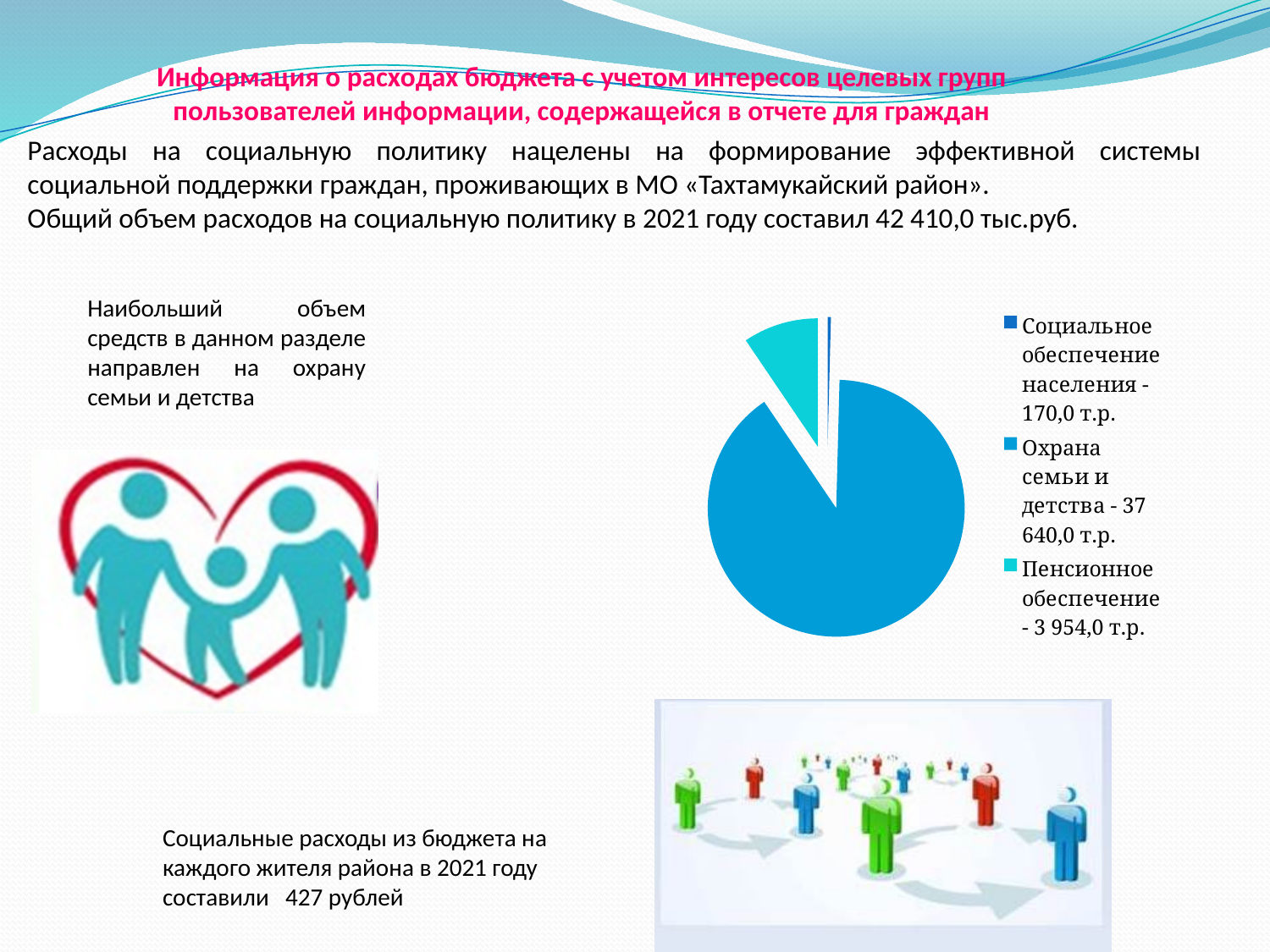
Which category has the smallest slice in the pie chart? Социальное обеспечение населения Which category has the largest slice in the pie chart? Охрана семьи и детства What colour is the slice for Охрана семьи и детства in the pie chart? blue What type of chart is shown on the slide? pie chart According to the pie chart legend, what is the value for Охрана семьи и детства? 37 640,0 т.р. According to the pie chart legend, what is the value for Социальное обеспечение населения? 170,0 т.р. How many entries does the legend of the pie chart list? 3 According to the pie chart legend, what is the value for Пенсионное обеспечение? 3 954,0 т.р. Which is larger in the pie chart: Пенсионное обеспечение or Социальное обеспечение населения? Пенсионное обеспечение What is the difference between the values for Охрана семьи и детства and Пенсионное обеспечение in the pie chart? 33 686,0 т.р. What is the difference between the values for Пенсионное обеспечение and Социальное обеспечение населения in the pie chart? 3 784,0 т.р. How many slices does the pie chart have? 3